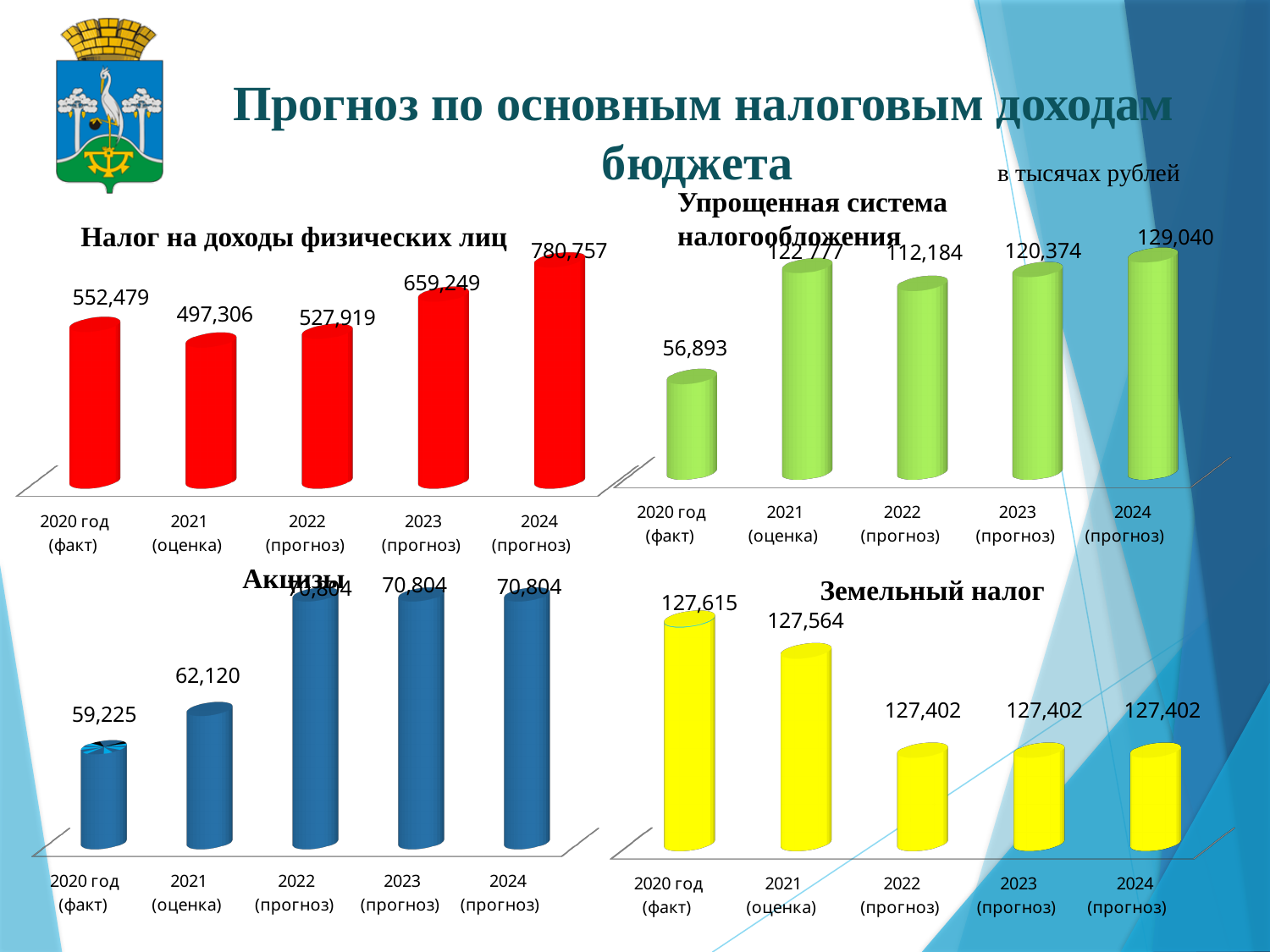
In the chart 'Налог на доходы физических лиц', what is the value for 2024 (прогноз)? 780,757 In the chart 'Упрощенная система налогообложения', which year has the highest value? 2024 (прогноз) What type of chart is 'Акцизы'? Bar chart In the chart 'Налог на доходы физических лиц', which year has the lowest value? 2021 (оценка) In the chart 'Упрощенная система налогообложения', which is larger: the value for 2022 (прогноз) or 2023 (прогноз)? 2023 (прогноз) In the chart 'Упрощенная система налогообложения', what is the value for 2020 год (факт)? 56,893 How many categories (years) are shown in the chart 'Земельный налог'? 5 In the chart 'Налог на доходы физических лиц', what is the difference between the 2024 (прогноз) and 2023 (прогноз) values? 121,508 In the chart 'Акцизы', what is the value for 2021 (оценка)? 62,120 In the chart 'Земельный налог', what is the value for 2020 год (факт)? 127,615 In the chart 'Акцизы', what is the difference between the 2021 (оценка) and 2020 год (факт) values? 2,895 In the chart 'Земельный налог', what is the value for 2023 (прогноз)? 127,402